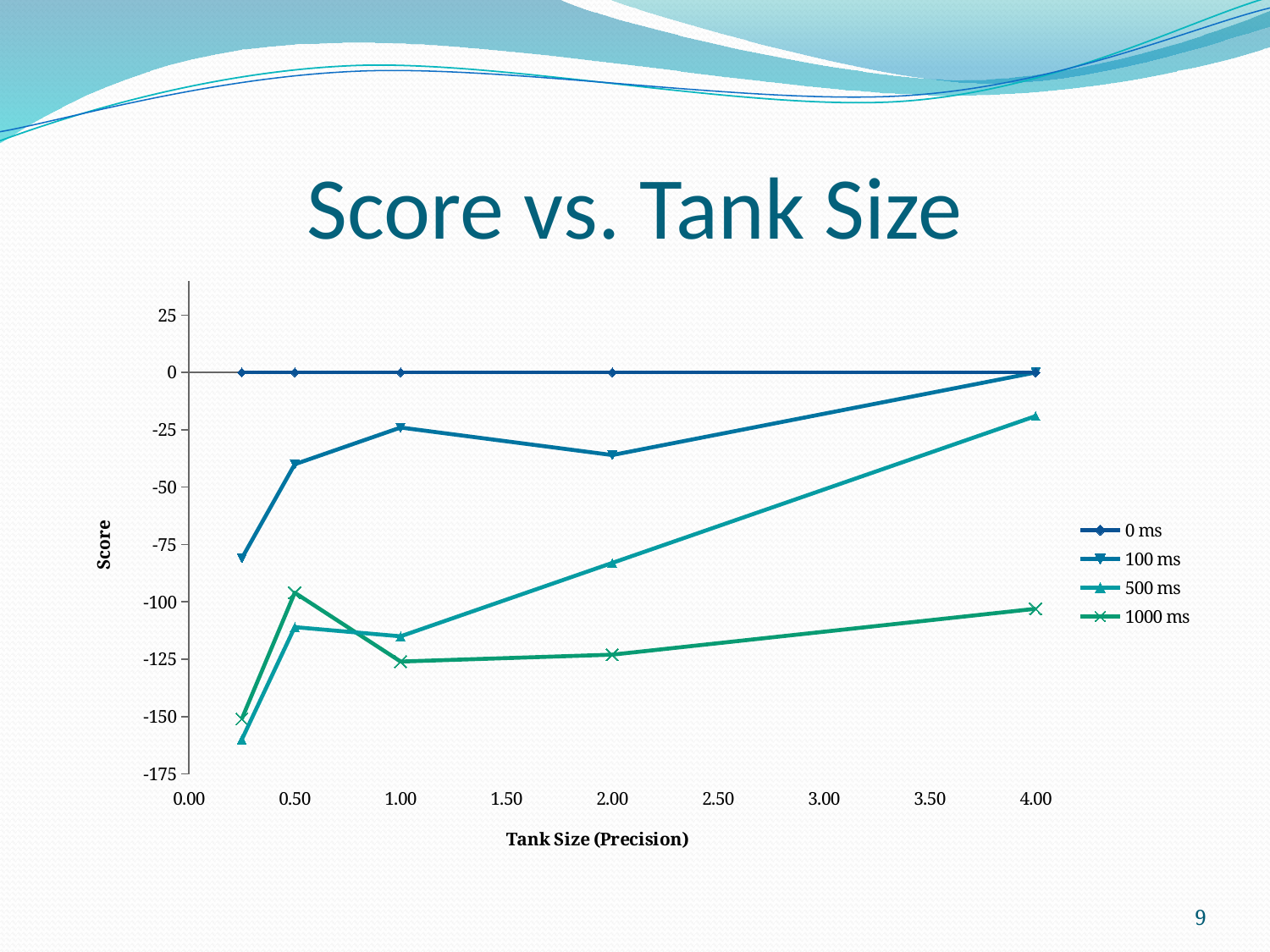
What is the title of the chart? Score vs. Tank Size Is the score for the 100 ms series at tank size 1.00 greater or less than -50? greater Does the score for the 500 ms series rise or fall from tank size 1.00 to 4.00? rise What type of chart is shown on the slide? line chart At tank size 4.00, which series has the higher score, 500 ms or 1000 ms? 500 ms What is the score for the 0 ms series at tank size 2.00? 0 How many series does the legend list? 4 What is the label of the x axis? Tank Size (Precision) Which series has the lowest score at tank size 0.25? 500 ms Which series has the highest score at tank size 2.00? 0 ms Is the score for the 1000 ms series at tank size 4.00 greater or less than -125? greater Is the score for the 500 ms series at tank size 0.25 greater or less than -150? less